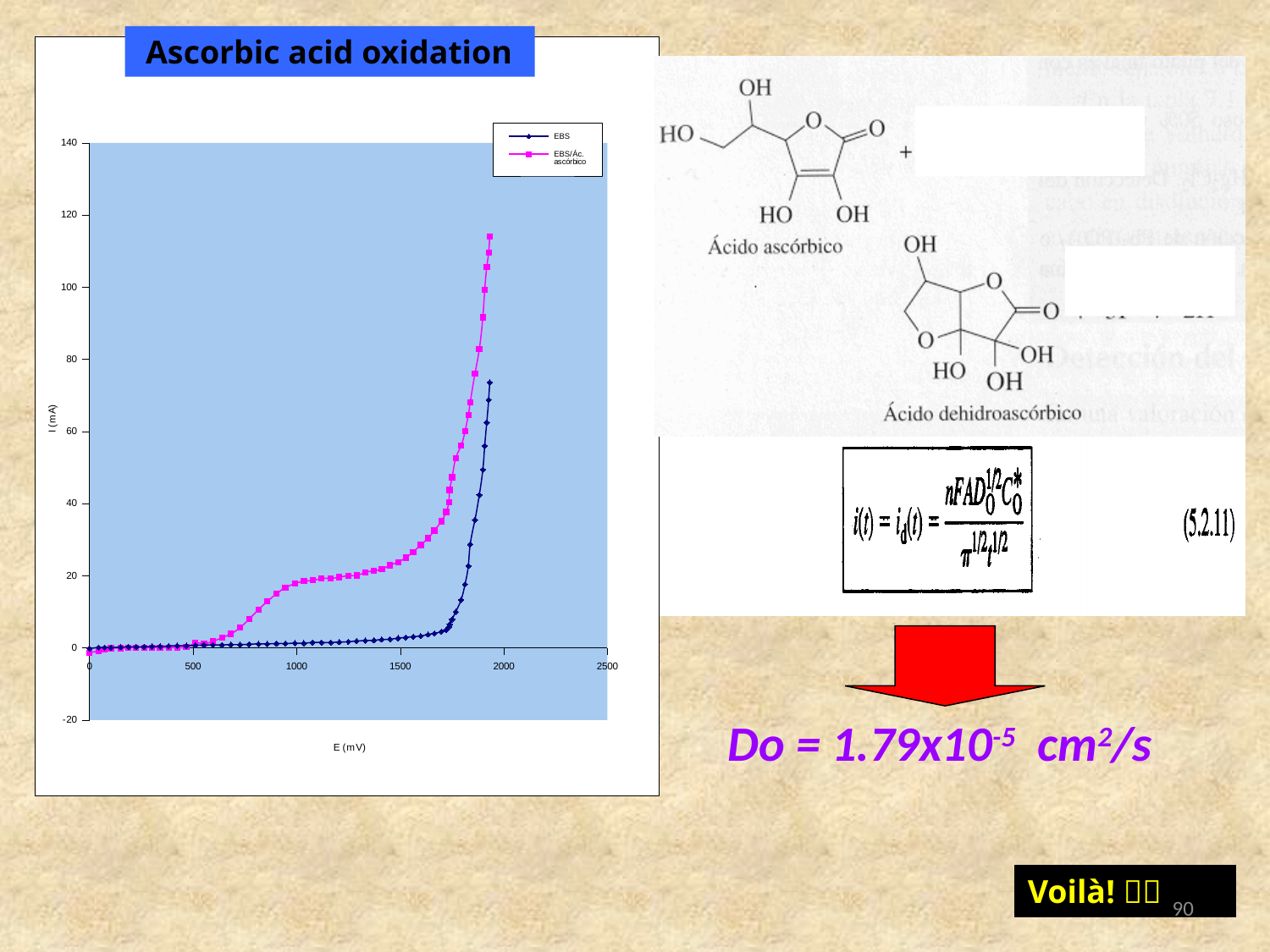
Is the highest value of the EBS series greater or less than 80 mA? less How many series does the chart legend list? 2 Is the value of the EBS series at 1500 mV greater or less than 20 mA? less Do the current values of the EBS/Ác. ascórbico series rise or fall as E (mV) increases? rise What are the two series named in the chart legend? EBS and EBS/Ác. ascórbico Is the highest value of the EBS series greater or less than 60 mA? greater At 1500 mV, which series has the larger current, EBS or EBS/Ác. ascórbico? EBS/Ác. ascórbico What kind of chart is shown on the slide? line chart What is the label of the chart's x axis? E (mV) Which series reaches the higher current at the right end of the curves, EBS or EBS/Ác. ascórbico? EBS/Ác. ascórbico